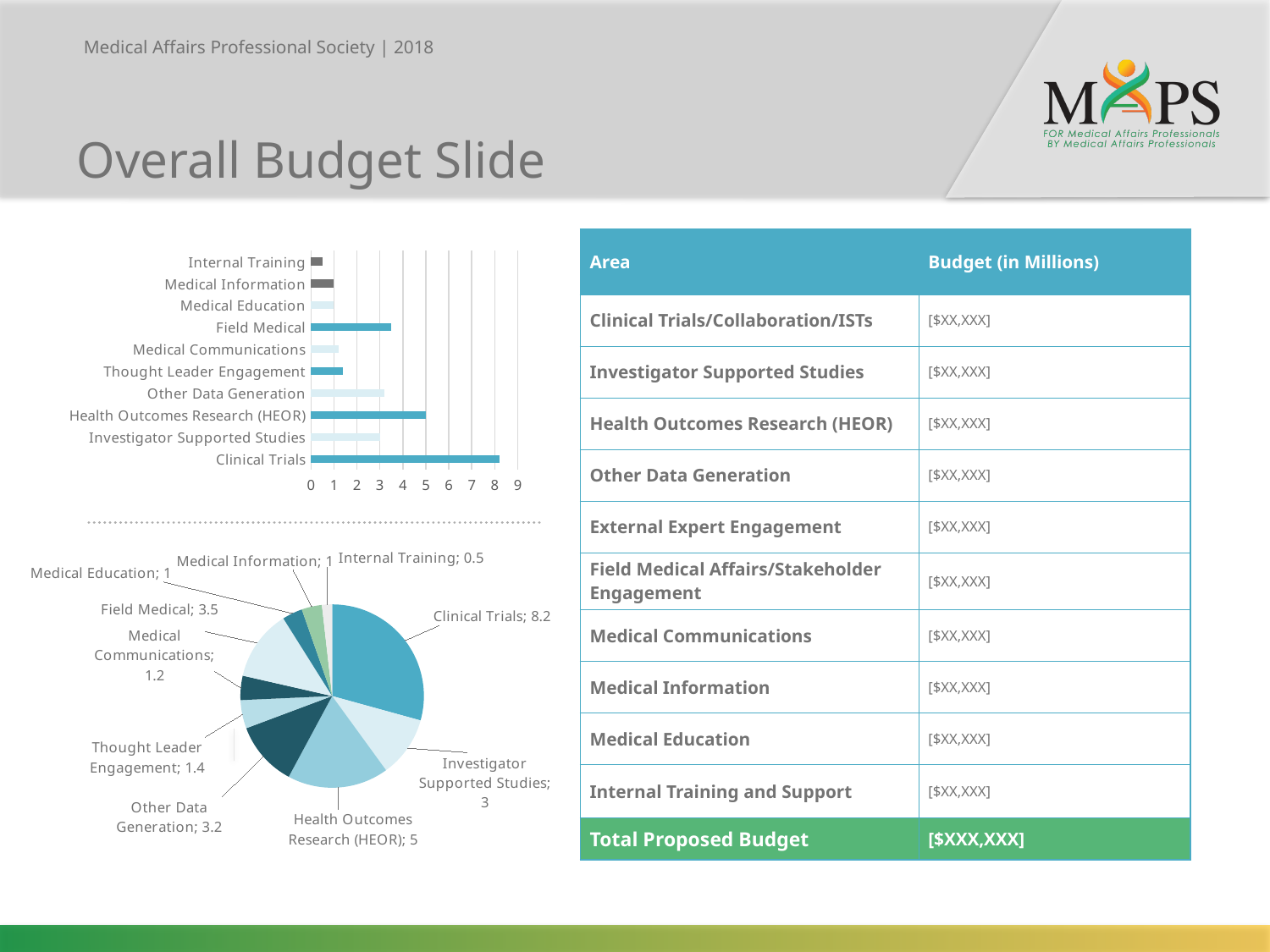
In the pie chart, what is the value for Health Outcomes Research (HEOR)? 5 In the pie chart, which category has the smallest value? Internal Training In the bar chart, is the value for Internal Training greater or less than 1? less In the pie chart, what is the value for Clinical Trials? 8.2 In the pie chart, which category has the largest value? Clinical Trials In the pie chart, what is the value for Thought Leader Engagement? 1.4 In the pie chart, what is the difference between the values for Investigator Supported Studies and Medical Communications? 1.8 What kind of chart is the top chart on the left of the slide? Bar chart In the pie chart, what is the difference between the values for Clinical Trials and Health Outcomes Research (HEOR)? 3.2 How many categories are shown in the bar chart? 10 In the bar chart, is the value for Health Outcomes Research (HEOR) greater or less than 4? greater